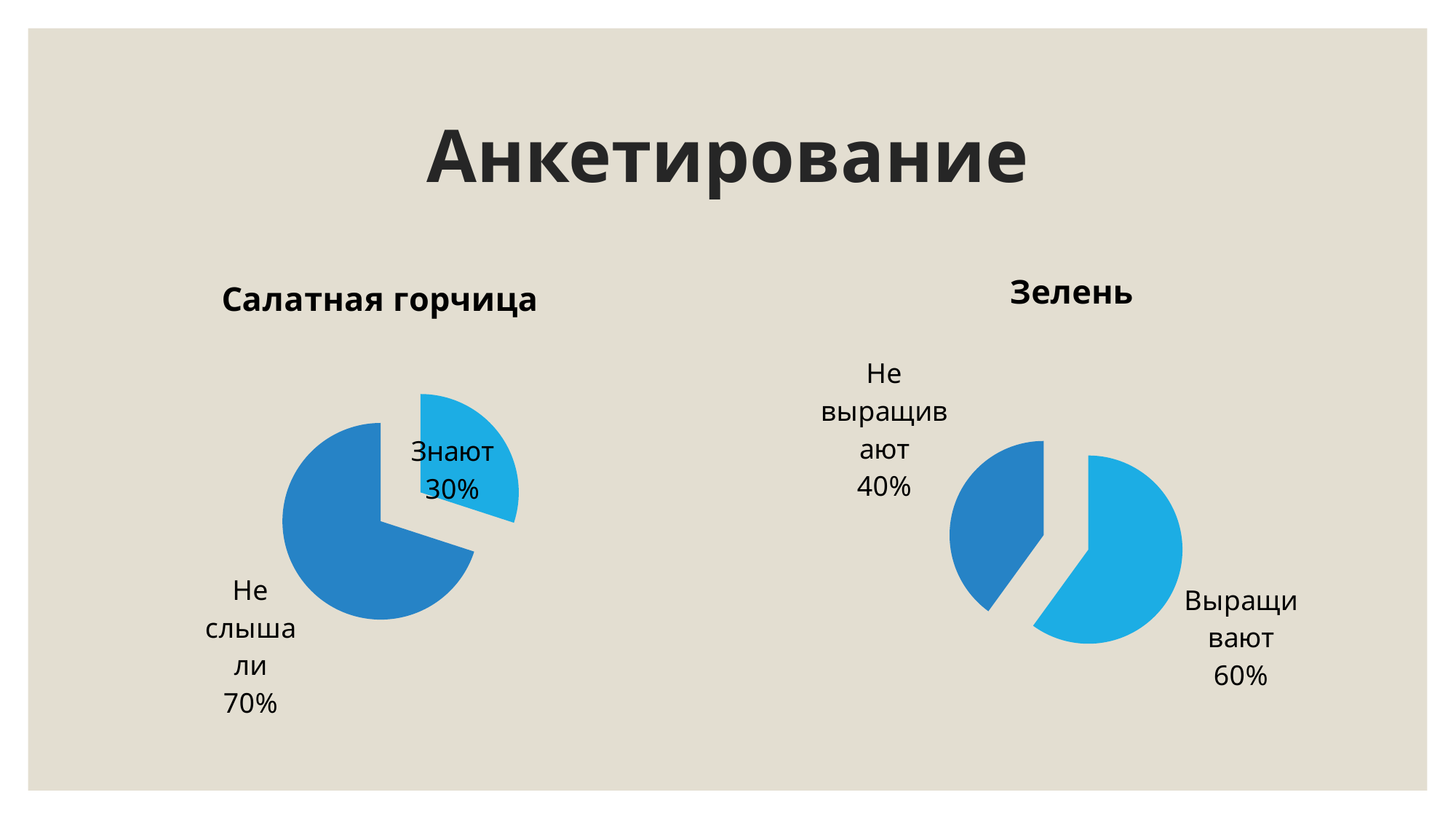
In the 'Зелень' chart, which slice is the smallest? Не выращивают In the 'Салатная горчица' chart, what is the difference between the 'Не слышали' and 'Знают' shares? 40% In the 'Зелень' chart, what share is labelled 'Выращивают'? 60% What is the title of the chart on the left of the slide? Салатная горчица What kind of chart is the 'Зелень' chart? Pie chart In the 'Зелень' chart, which is larger: 'Выращивают' or 'Не выращивают'? Выращивают In the 'Салатная горчица' chart, which slice is the largest? Не слышали In the 'Зелень' chart, what share is labelled 'Не выращивают'? 40% In the 'Салатная горчица' chart, what share is labelled 'Не слышали'? 70% In the 'Салатная горчица' chart, what share is labelled 'Знают'? 30% How many slices does the 'Салатная горчица' chart have? 2 In the 'Зелень' chart, what is the difference between the 'Выращивают' and 'Не выращивают' shares? 20%